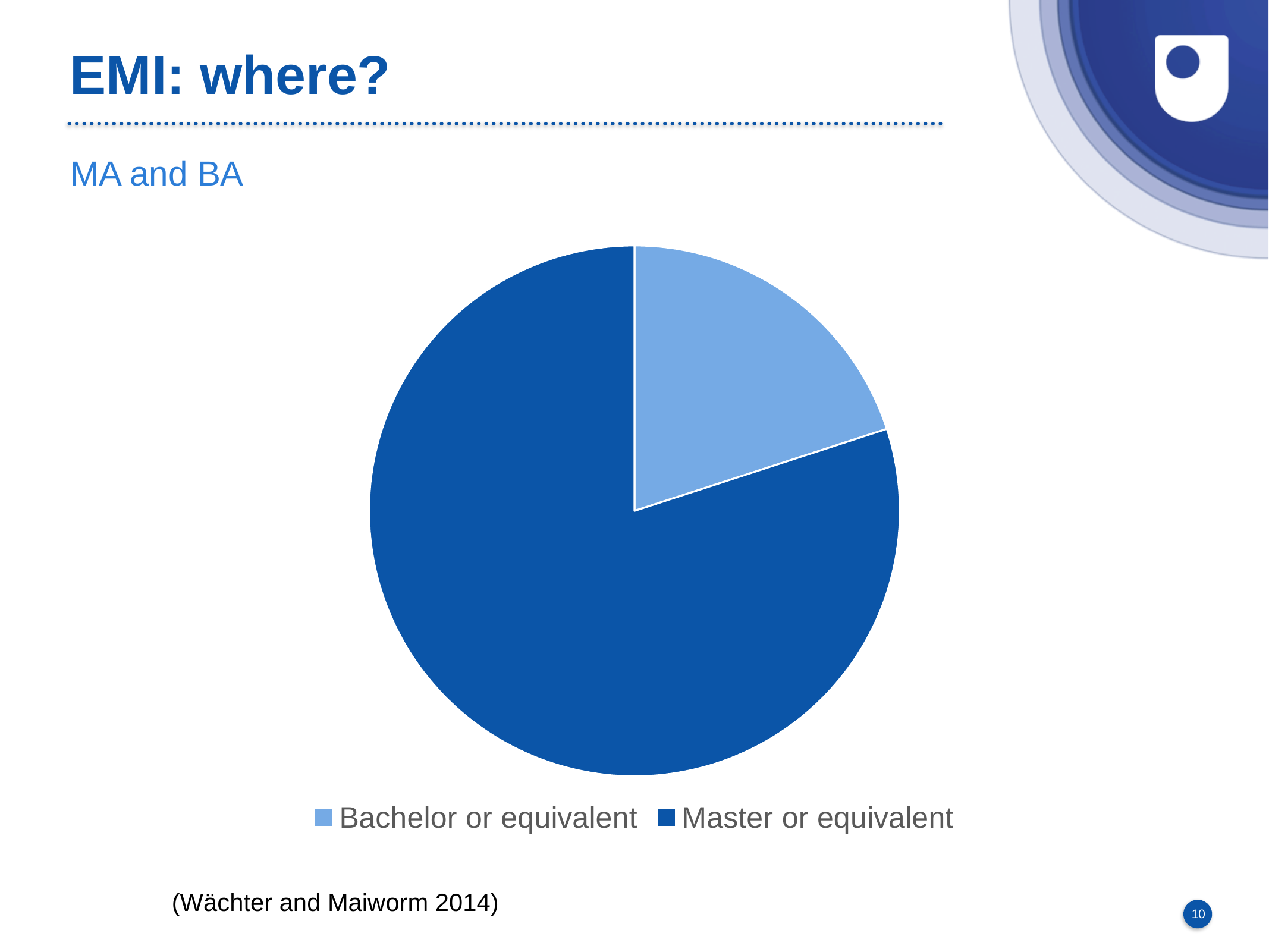
Which legend entry is shown in the lighter blue colour? Bachelor or equivalent Which slice of the pie chart is the largest? Master or equivalent What is the subtitle shown above the pie chart? MA and BA How many slices does the pie chart have? 2 Which is larger in the pie chart, Bachelor or equivalent or Master or equivalent? Master or equivalent How many entries does the legend of the pie chart list? 2 What kind of chart is shown on the slide? pie chart Which slice of the pie chart is the smallest? Bachelor or equivalent